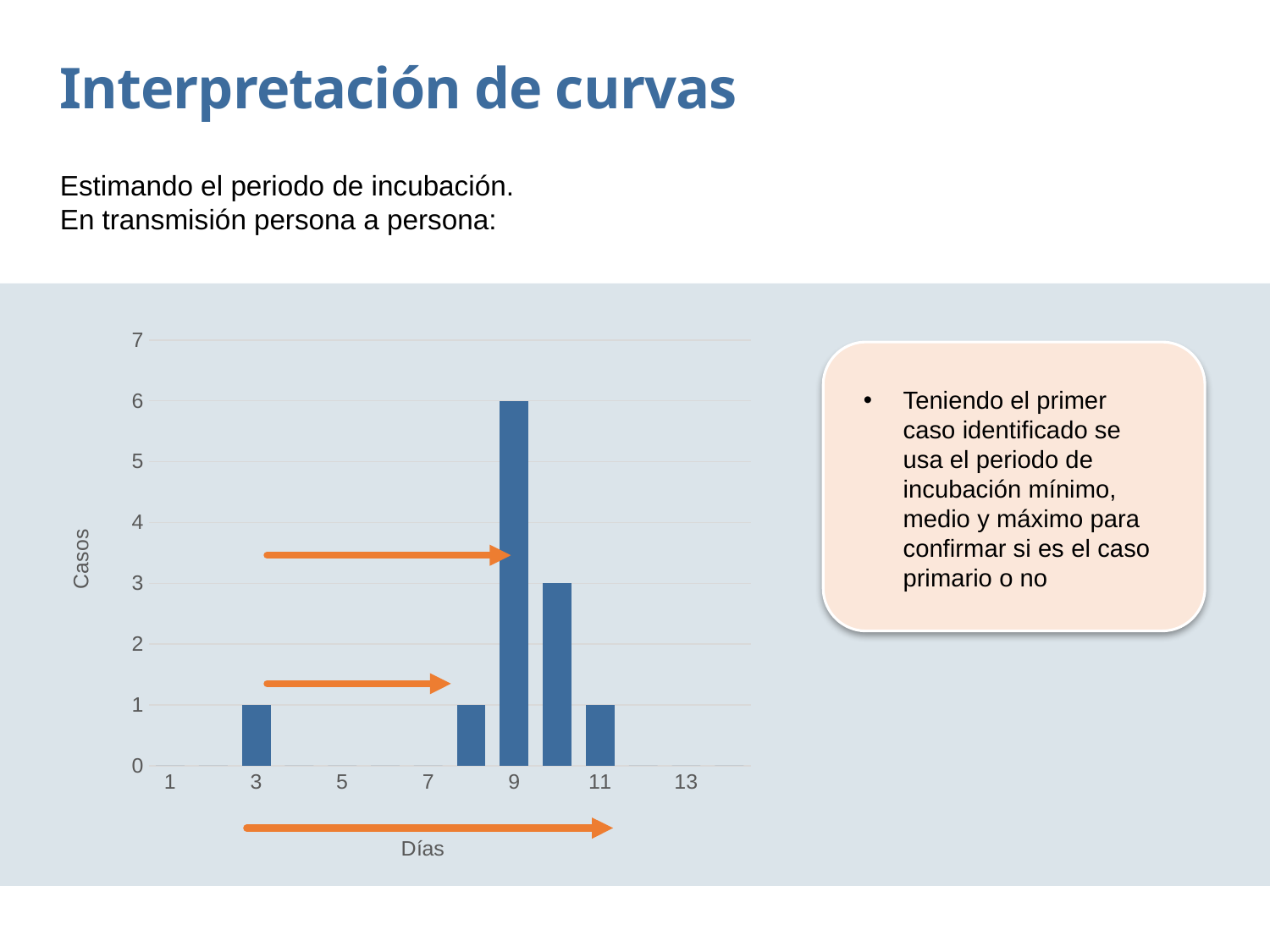
How many bars are plotted in the chart? 5 What is the title of the horizontal axis of the chart? Días What is the title of the vertical axis of the chart? Casos What is the difference in cases between day 9 and day 3? 5 On which day does the chart show the highest number of cases? 9 What kind of chart is shown on the slide? bar chart Is the number of cases on day 9 greater or less than 4? greater How many cases are shown for day 11? 1 How many cases are shown for day 3? 1 Is the number of cases on day 3 greater or less than 2? less How many cases are shown for day 9? 6 Which day has more cases, day 9 or day 11? 9